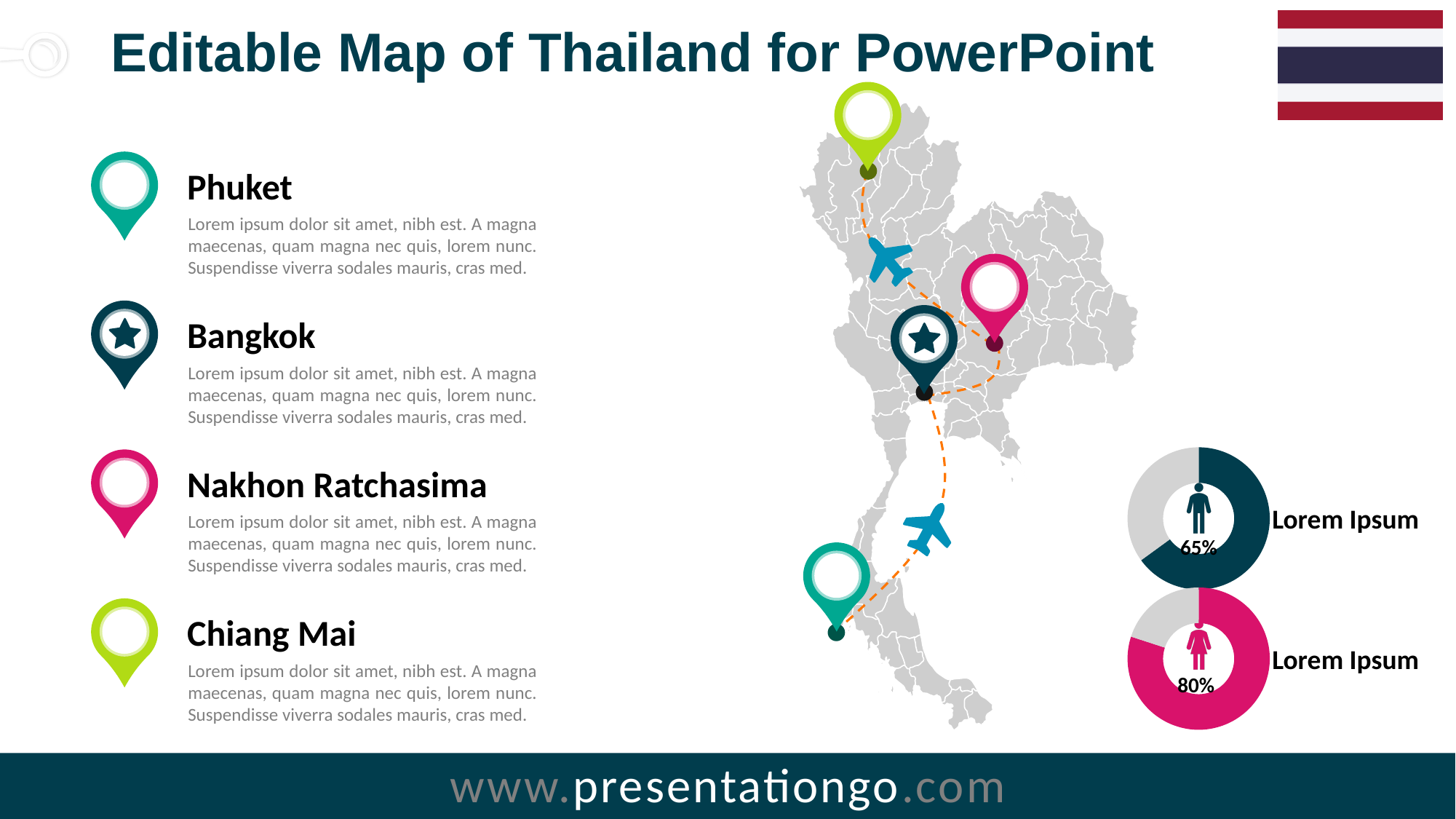
What label text appears to the right of each donut chart? Lorem Ipsum Which donut chart shows the larger percentage, the upper dark teal one or the lower pink one? the lower pink one Is the value shown on the upper dark teal donut chart greater or less than 50%? greater What is the difference between the percentages shown on the lower pink donut chart and the upper dark teal donut chart? 15% What percentage is printed on the lower donut chart (the pink one with the female figure)? 80% Is the value shown on the lower pink donut chart greater or less than 75%? greater What colour is the filled portion of the lower donut chart showing 80%? pink What percentage is printed on the upper donut chart (the dark teal one with the male figure)? 65% How many donut charts are shown on the slide? 2 What kind of chart is shown in the lower right of the slide next to the male figure icon? donut chart